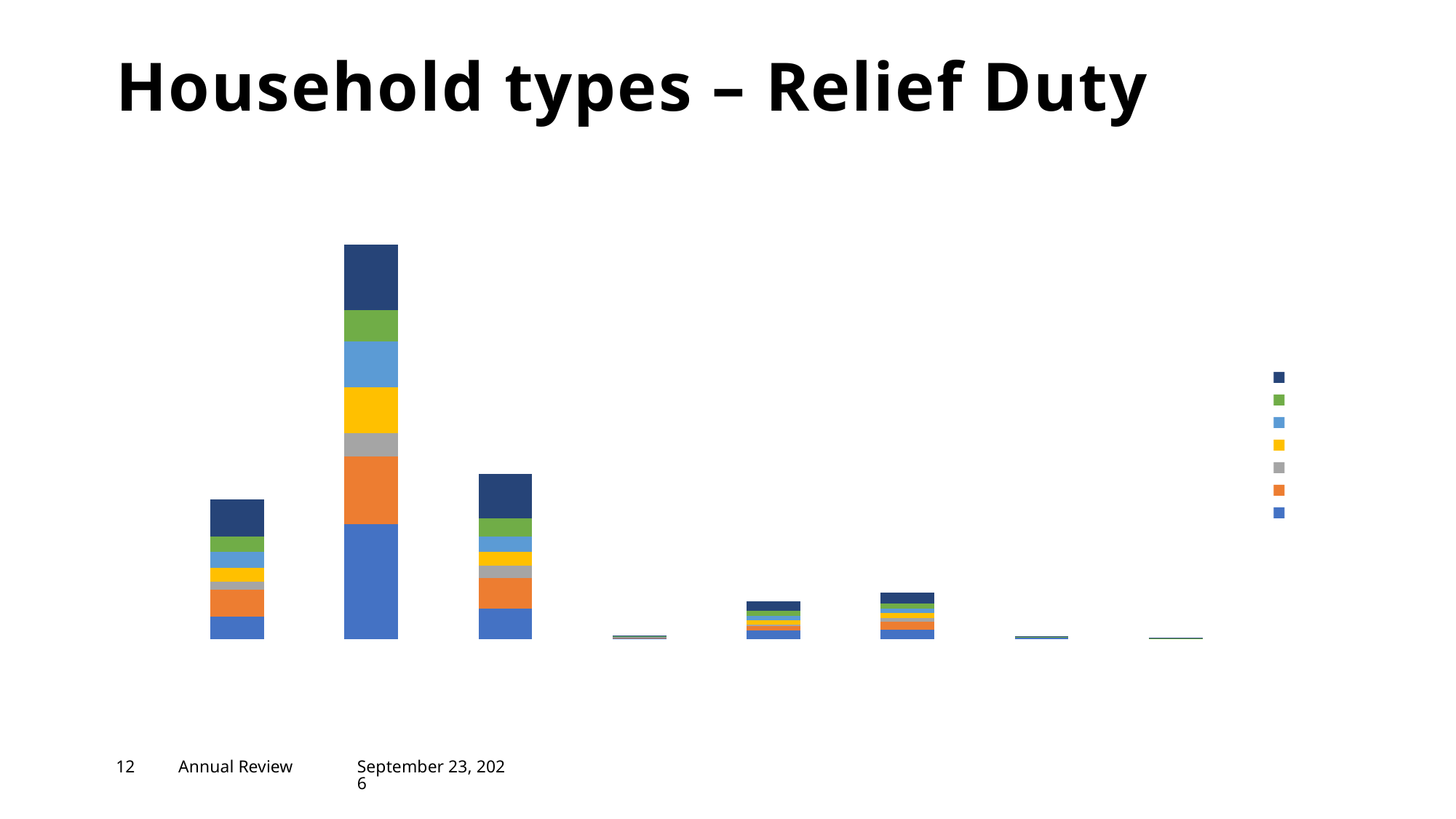
Which bar is the tallest in the chart, counting from the left? The second bar Is the second bar from the left taller or shorter than the third bar from the left? Taller How many bars (categories) are plotted in the chart? 8 How many series does the legend list? 7 What is the title of the slide containing the chart? Household types – Relief Duty What colour is the bottom segment of each stacked bar? Blue Is the first bar from the left taller or shorter than the second bar from the left? Shorter What kind of chart is shown on the slide? Stacked bar chart